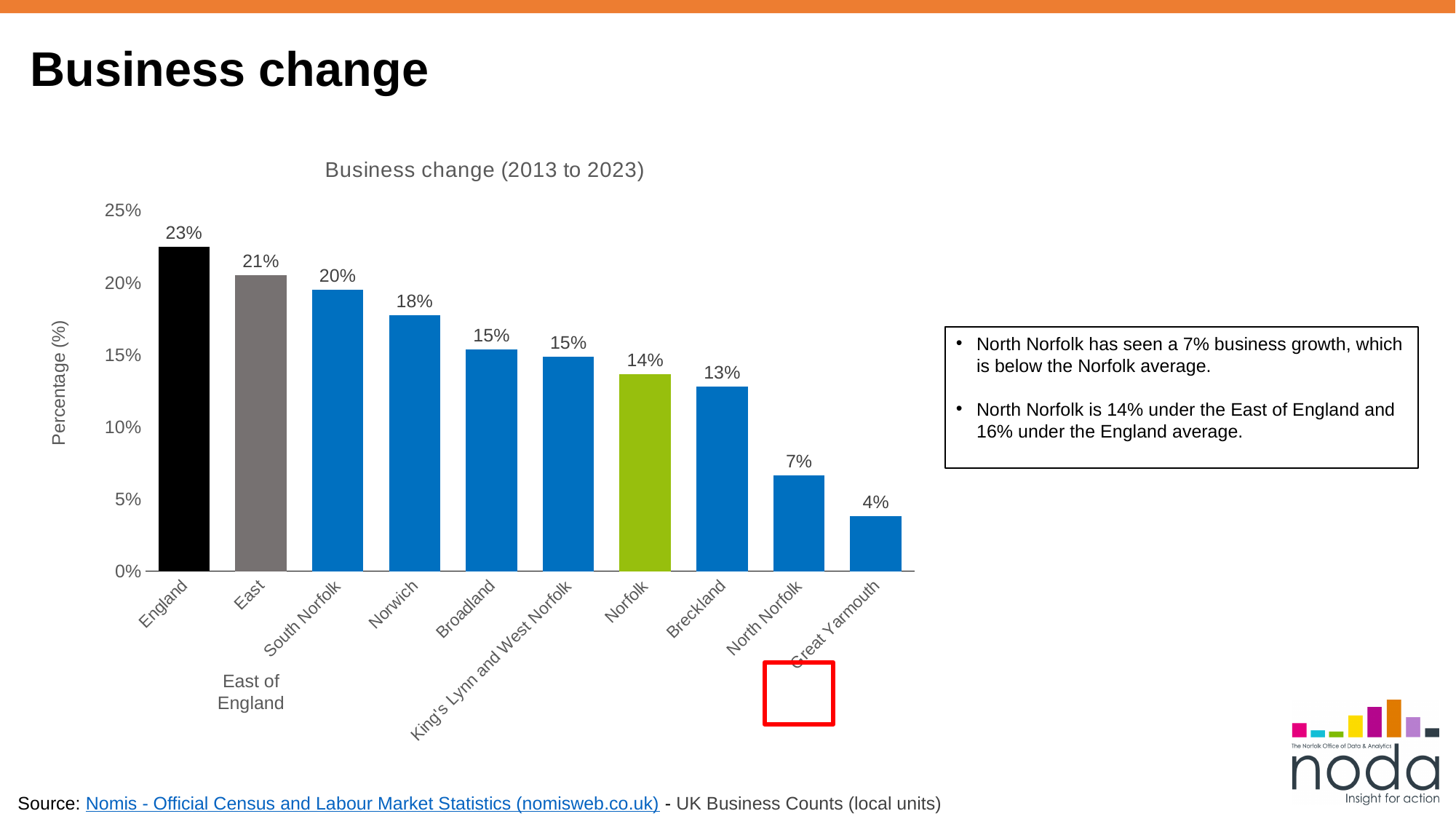
Do the values rise or fall from left to right along the x axis? Fall What is the business change value for Norfolk? 14% How many categories are shown on the x axis? 10 Which category has the highest business change? England What kind of chart is shown on the slide? Bar chart What is the title of the chart? Business change (2013 to 2023) What is the business change value for England? 23% What is the difference between the business change for England and North Norfolk? 16% Which category has the lowest business change? Great Yarmouth Is the value for Breckland greater or less than 10%? greater Which has a larger business change, South Norfolk or Norwich? South Norfolk What is the business change value for North Norfolk? 7%